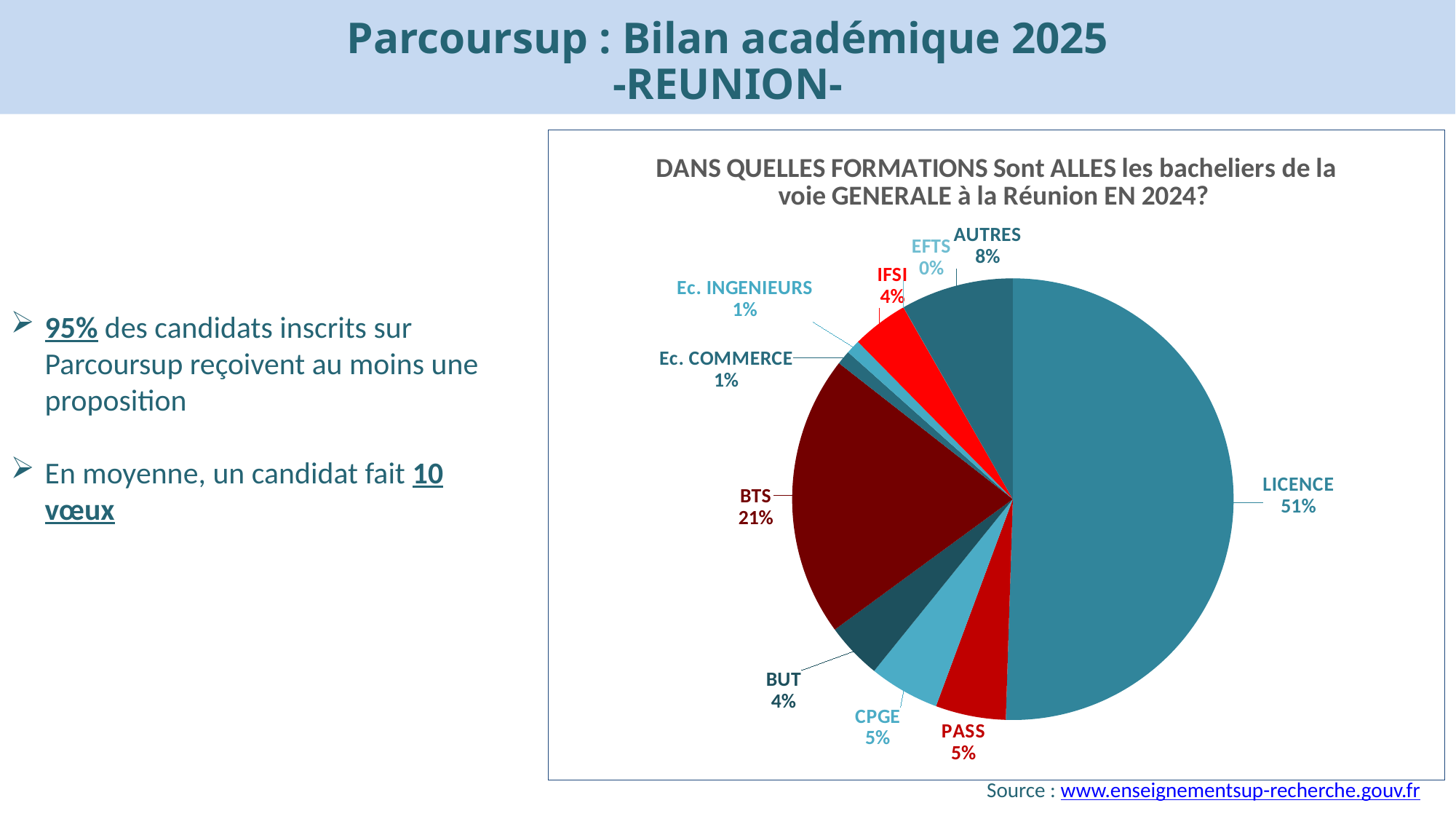
Which category has the smallest slice of the pie? EFTS Which is larger, the share for AUTRES or the share for CPGE? AUTRES What is the title of the chart? DANS QUELLES FORMATIONS Sont ALLES les bacheliers de la voie GENERALE à la Réunion EN 2024? How many categories are shown in the pie chart? 10 What share of the pie does LICENCE represent? 51% Which category has the largest slice of the pie? LICENCE What is the value shown for AUTRES? 8% What type of chart is shown on the slide? Pie chart What percentage is shown for BTS? 21% What is the difference in percentage points between LICENCE and BTS? 30 What percentage is shown for EFTS? 0% What is the combined share of BUT and IFSI? 8%